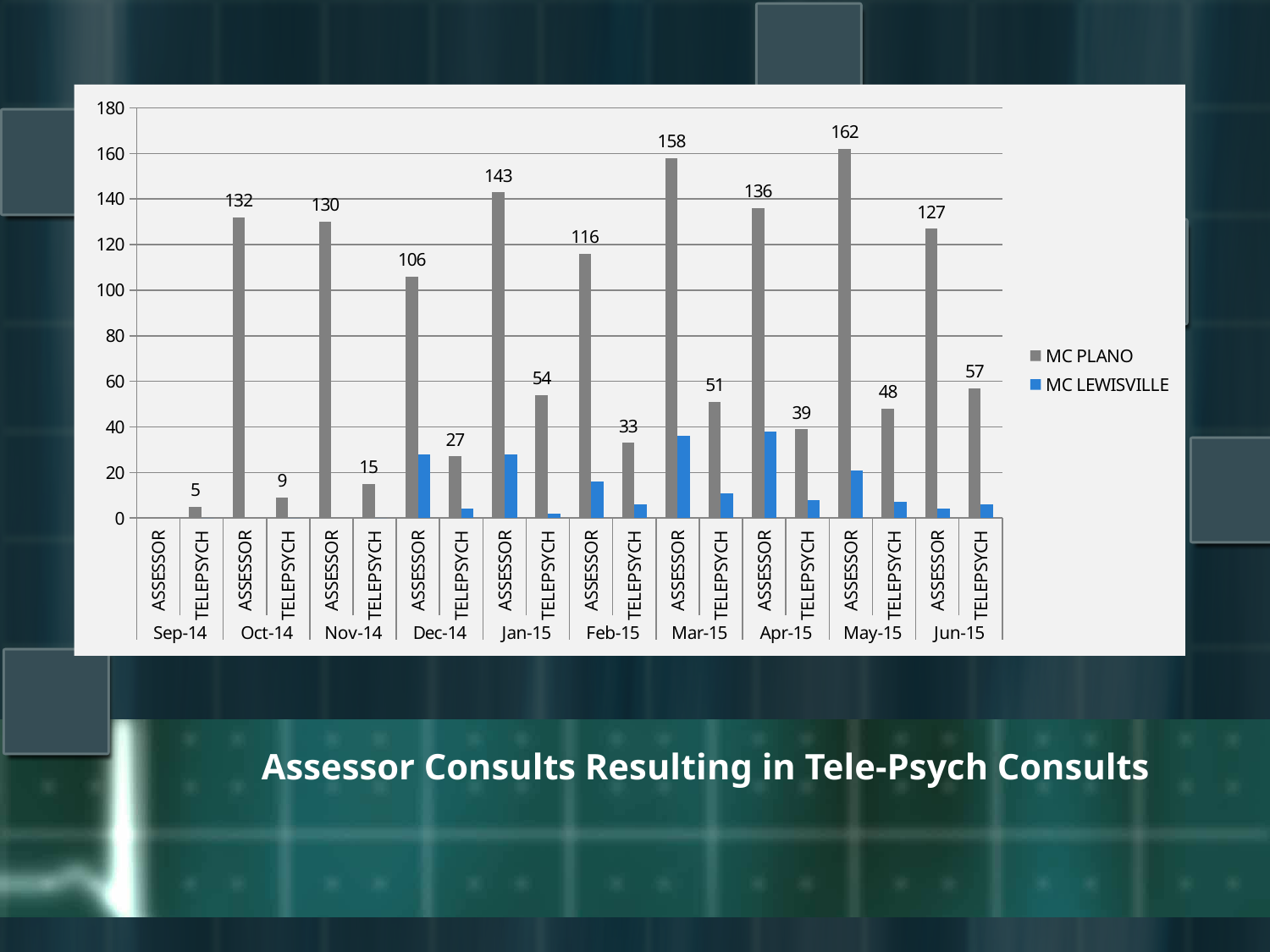
Is the MC LEWISVILLE value for TELEPSYCH in Jan-15 greater or less than 20? less What kind of chart is shown on the slide? Bar chart What is the MC PLANO value for TELEPSYCH in Jan-15? 54 What is the MC PLANO value for ASSESSOR in May-15? 162 Which is larger for MC PLANO: the ASSESSOR value in Oct-14 or in Nov-14? Oct-14 Is the MC LEWISVILLE value for ASSESSOR in Apr-15 greater or less than 20? greater What is the difference between the MC PLANO ASSESSOR values for Mar-15 and Feb-15? 42 What is the MC PLANO value for ASSESSOR in Dec-14? 106 Which month has the lowest MC PLANO TELEPSYCH value? Sep-14 How many series does the legend list? 2 How many months are shown along the x axis? 10 In which month does the MC PLANO ASSESSOR bar reach its highest value? May-15